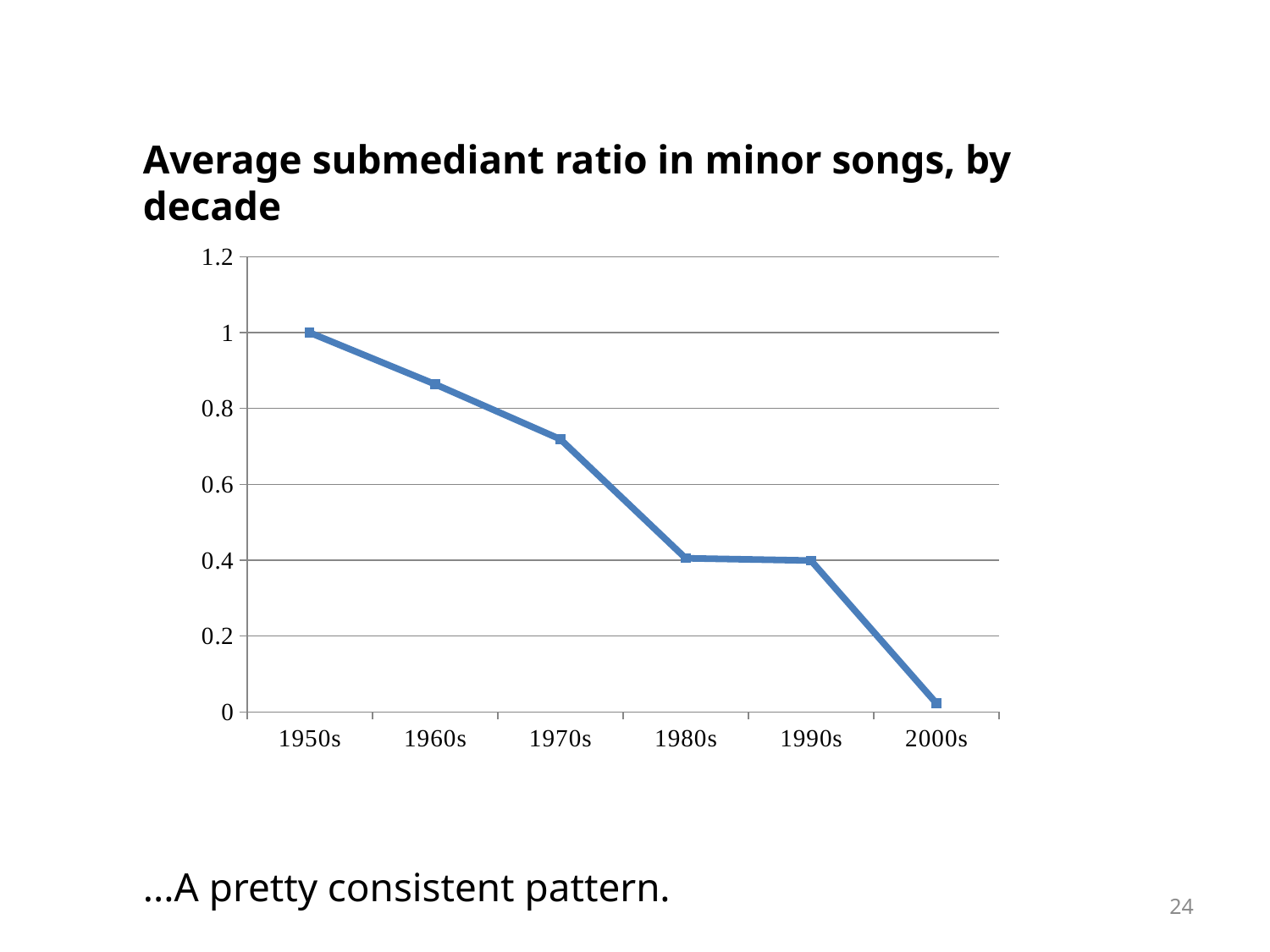
Do the values rise or fall from the 1950s to the 2000s? fall Which decade has the lowest average submediant ratio? 2000s How many decades are plotted on the x axis? 6 What is the average submediant ratio for the 1950s? 1 Is the value for the 1980s greater or less than 0.6? less Which decade has the highest average submediant ratio? 1950s Which has a larger average submediant ratio, the 1960s or the 1970s? 1960s Is the value for the 1970s greater or less than 0.8? less What kind of chart is shown on the slide? line chart What is the title of the chart? Average submediant ratio in minor songs, by decade Is the value for the 2000s greater or less than 0.2? less